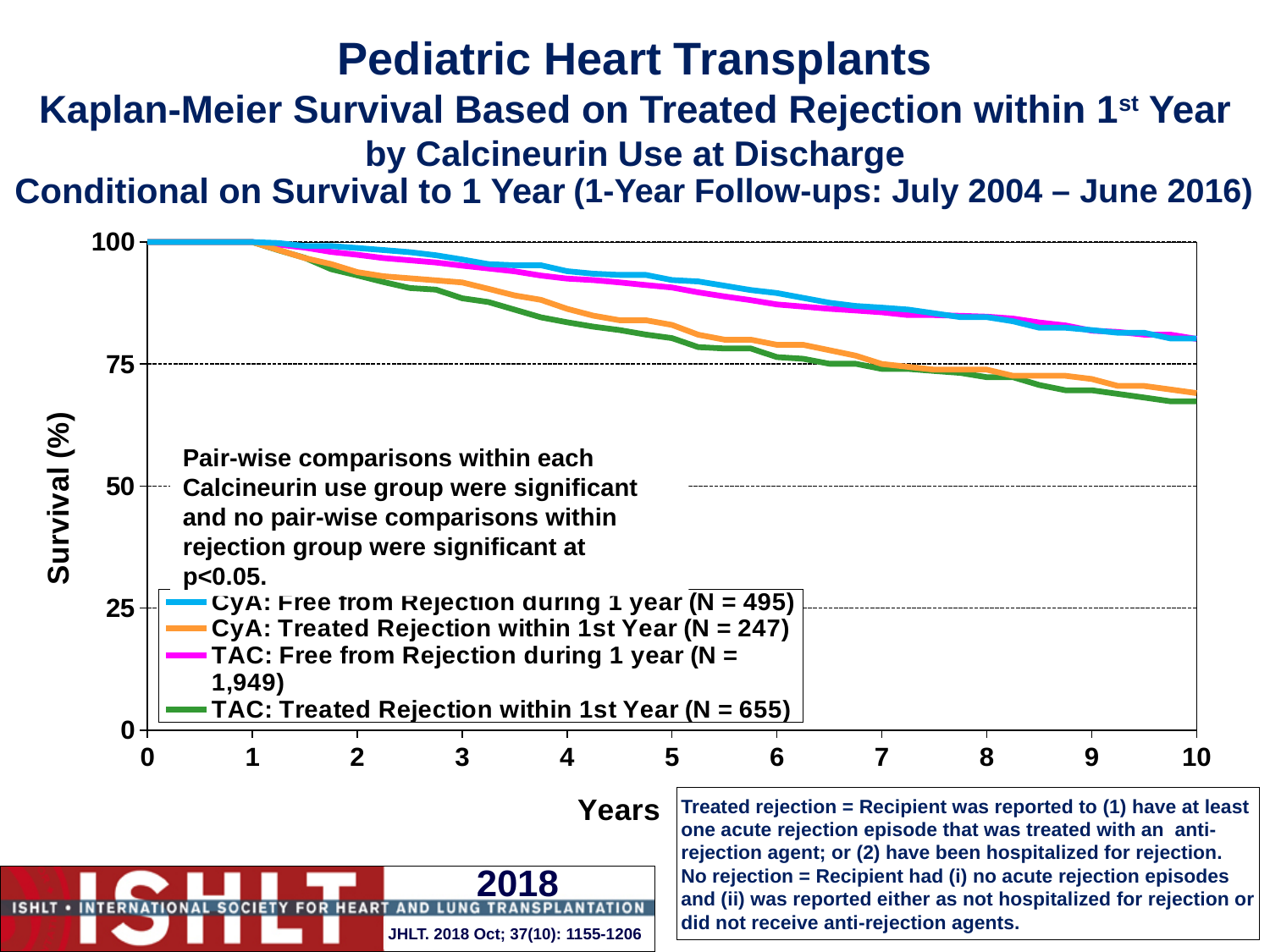
What is the N for the series 'TAC: Free from Rejection during 1 year'? 1,949 What kind of chart is shown on the slide? Line chart At year 3, which series has higher survival: 'CyA: Free from Rejection during 1 year' or 'TAC: Treated Rejection within 1st Year'? CyA: Free from Rejection during 1 year Is the survival value for 'TAC: Treated Rejection within 1st Year' at year 10 greater or less than 75? less Is the survival value for 'TAC: Treated Rejection within 1st Year' at year 5 greater or less than 75? greater At year 3, which series has the lowest survival? TAC: Treated Rejection within 1st Year What is the label of the y axis? Survival (%) How many series does the legend list? 4 Do the survival curves rise or fall as years increase? Fall What is the N for the series 'CyA: Free from Rejection during 1 year'? 495 Is the survival value for 'CyA: Free from Rejection during 1 year' at year 10 greater or less than 75? greater What is the N for the series 'TAC: Treated Rejection within 1st Year'? 655